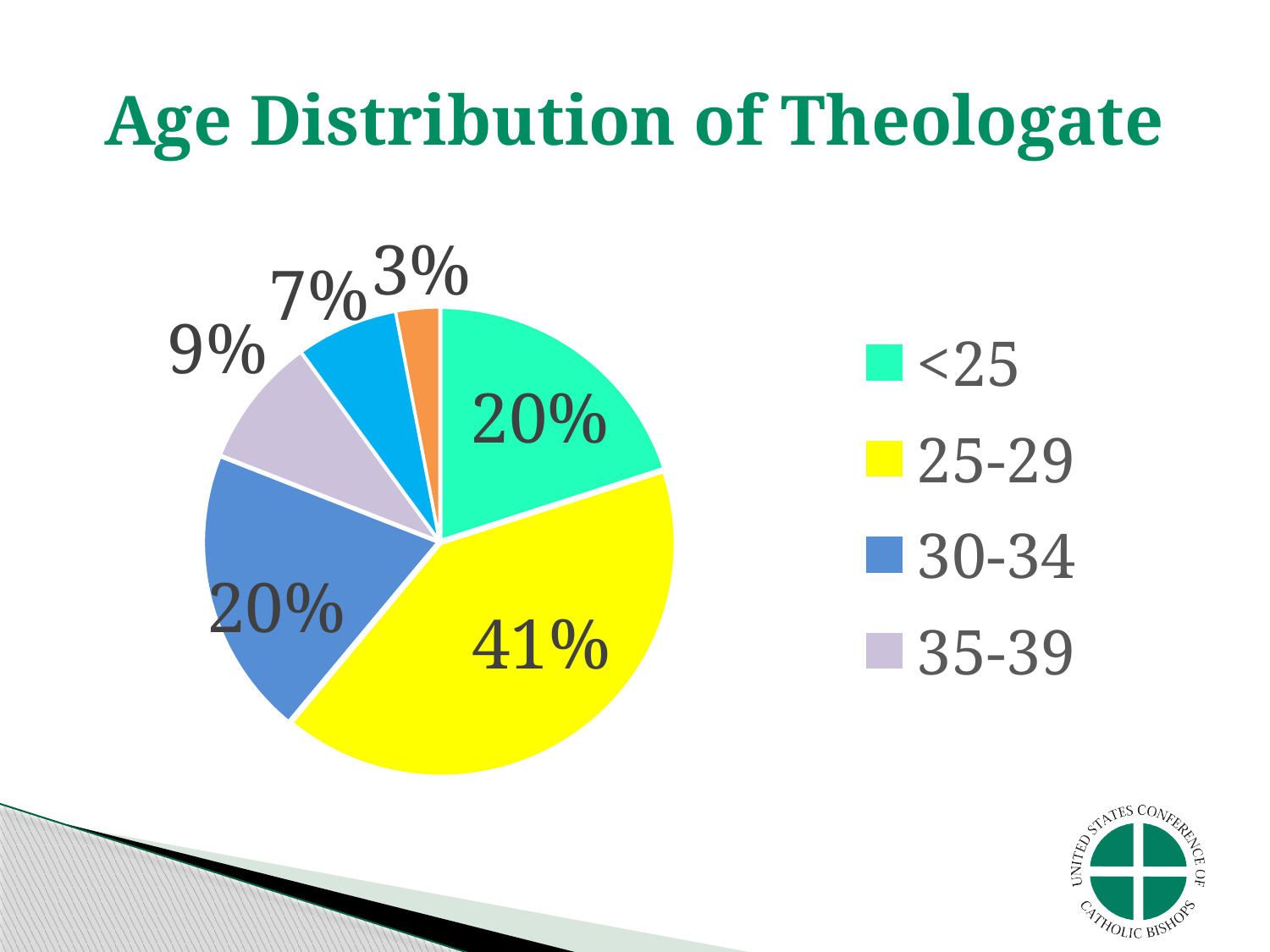
How many slices does the pie chart have? 6 How many entries does the legend list? 4 What is the title of the chart? Age Distribution of Theologate What percentage of the pie chart is the 30-34 age group? 20% How many percentage points larger is the 25-29 slice than the 35-39 slice? 32% Which age group has the largest slice of the pie chart? 25-29 What percentage of the pie chart is the 35-39 age group? 9% What percentage of the pie chart is the <25 age group? 20% Which slice is larger, <25 or 35-39? <25 What is the smallest percentage label shown on the pie chart? 3% What percentage of the pie chart is the 25-29 age group? 41% What kind of chart is shown on the slide? Pie chart